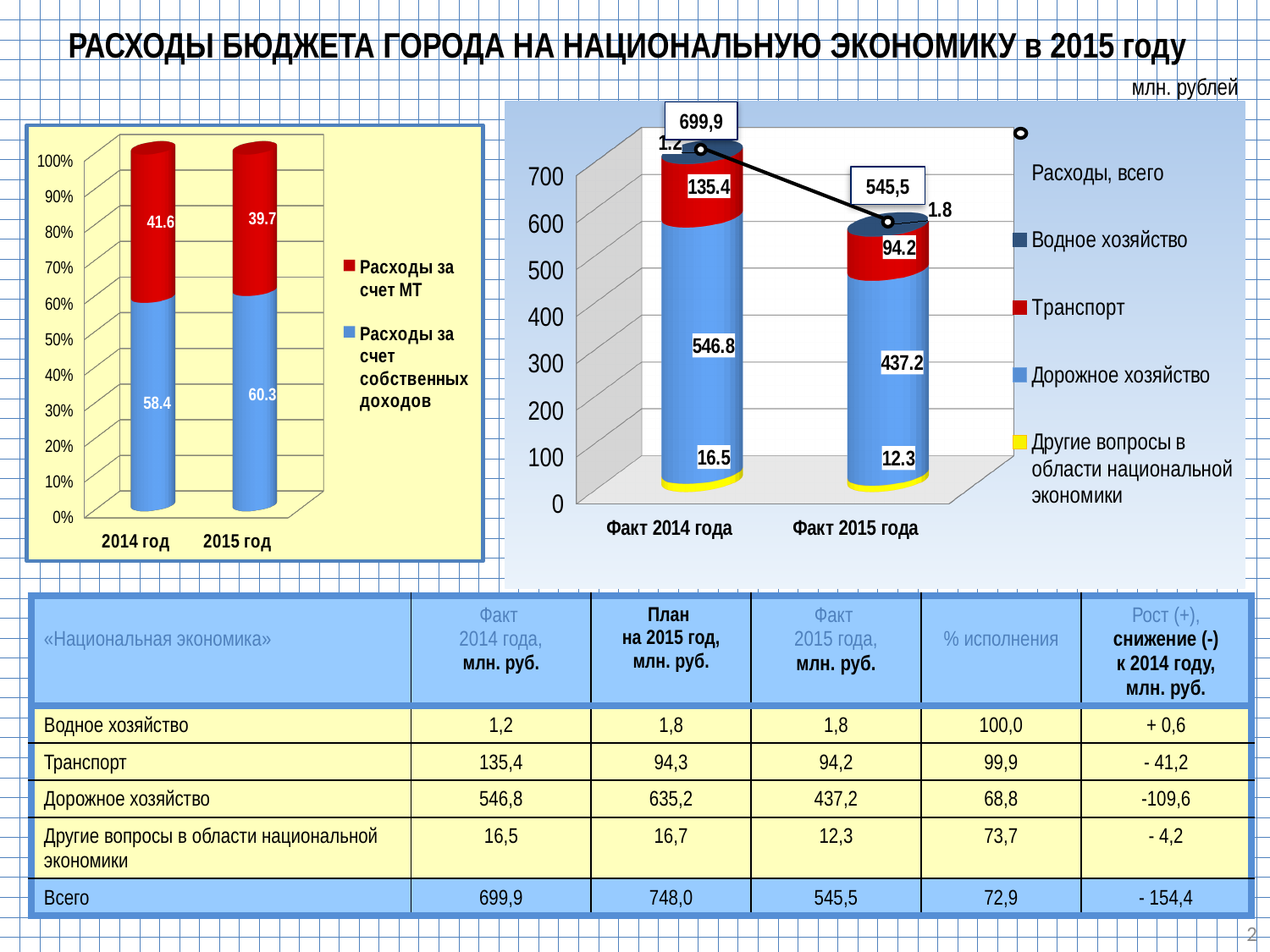
In the left chart, how many series does the legend list? 2 In the right chart, does the total 'Расходы, всего' rise or fall from Факт 2014 года to Факт 2015 года? fall In the right chart, how many categories are shown on the x axis? 2 What kind of chart is the right chart? stacked bar chart In the left chart, what is the value of 'Расходы за счет собственных доходов' for 2014 год? 58.4 In the right chart, what is the total 'Расходы, всего' for Факт 2015 года? 545,5 In the right chart, which category has the smallest value for Факт 2014 года? Водное хозяйство In the right chart, what is the value of 'Транспорт' for Факт 2014 года? 135.4 In the right chart, what is the difference between 'Дорожное хозяйство' for Факт 2014 года and Факт 2015 года? 109.6 In the left chart, what is the value of 'Расходы за счет МТ' for 2015 год? 39.7 In the right chart, what is the value of 'Дорожное хозяйство' for Факт 2015 года? 437.2 In the left chart, which year has the larger value for 'Расходы за счет МТ', 2014 год or 2015 год? 2014 год